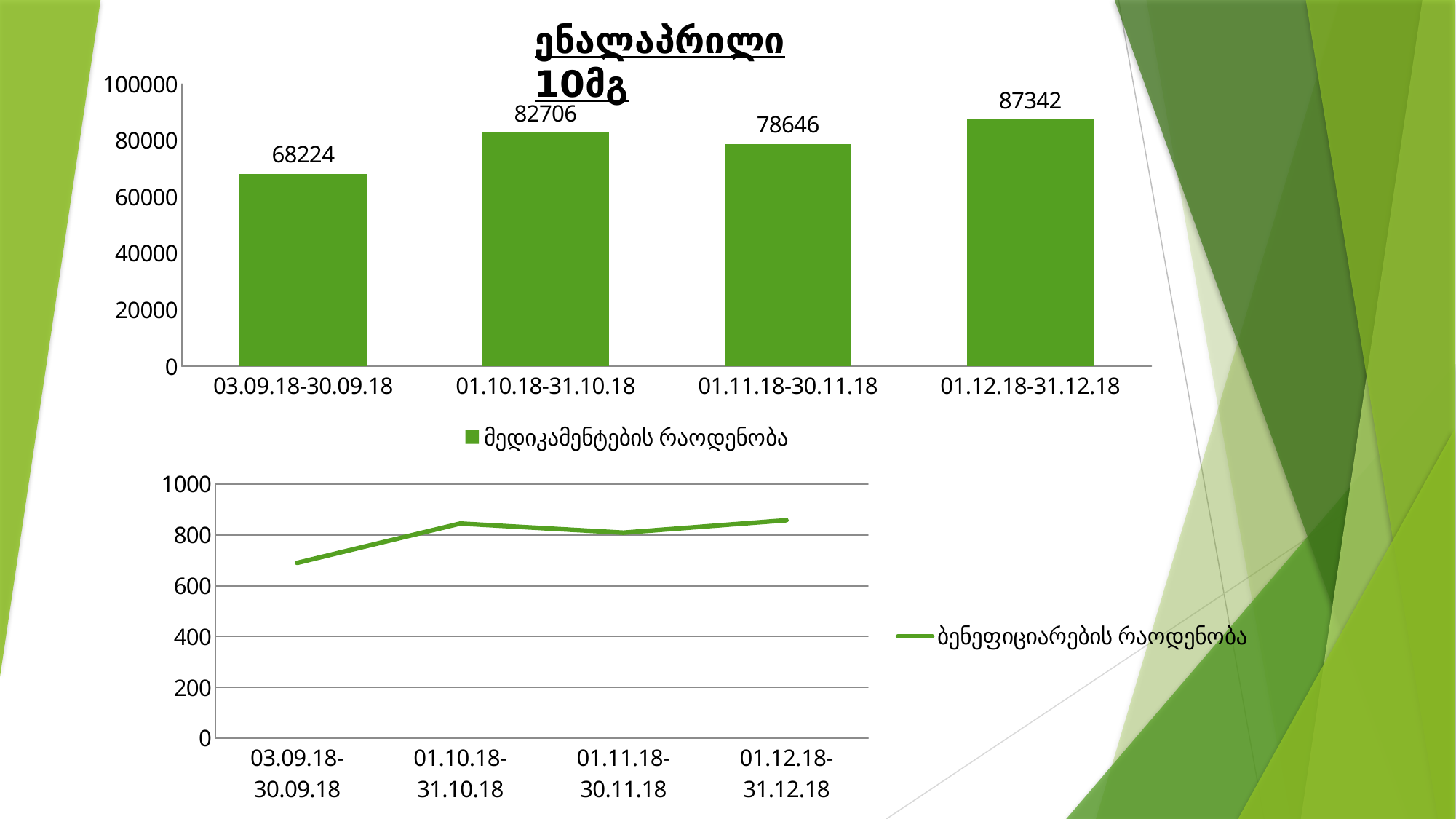
In the top bar chart, what is the value for 03.09.18-30.09.18? 68224 What is the legend entry of the bottom line chart? ბენეფიციარების რაოდენობა What kind of chart is the bottom chart on the slide? Line chart In the bottom line chart, is the value for 03.09.18-30.09.18 greater or less than 800? less In the bottom line chart, is the value for 01.12.18-31.12.18 greater or less than 800? greater In the top bar chart, what is the value for 01.11.18-30.11.18? 78646 In the top bar chart, which period has the highest value? 01.12.18-31.12.18 In the top bar chart, which period has the lowest value? 03.09.18-30.09.18 How many bars are in the top bar chart? 4 In the top bar chart, what is the difference between the values for 01.10.18-31.10.18 and 01.11.18-30.11.18? 4060 In the top bar chart, which is larger: the value for 01.10.18-31.10.18 or for 01.11.18-30.11.18? 01.10.18-31.10.18 In the top bar chart, what is the value for 01.12.18-31.12.18? 87342